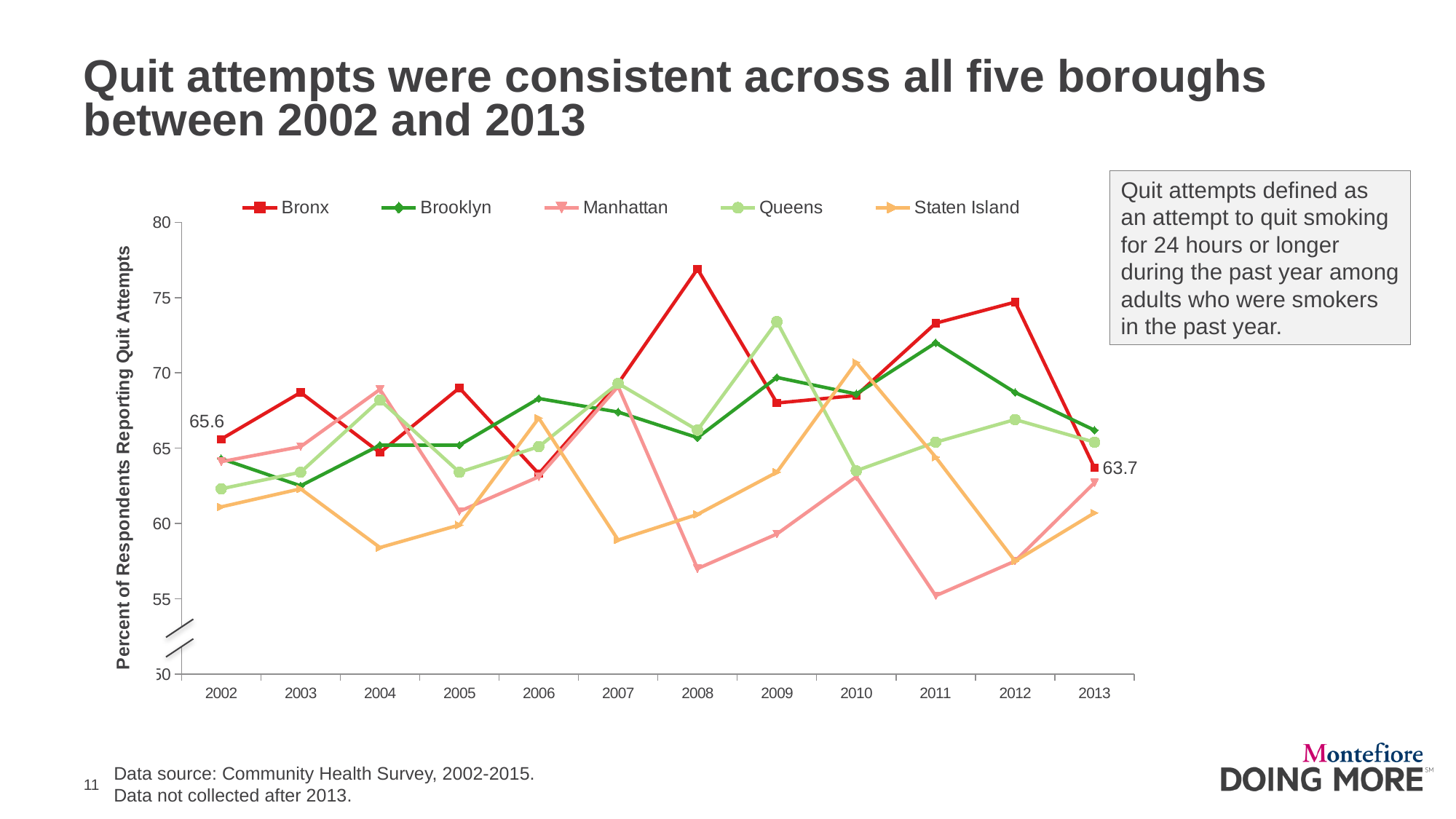
Which borough has the lowest value in 2011? Manhattan How many series does the legend list? 5 Which is larger for Bronx: the 2002 value or the 2013 value? 2002 How many years are shown on the x axis? 12 What is the difference between the Bronx value in 2002 and the Bronx value in 2013? 1.9 Which borough has the highest value in 2008? Bronx What is the value for Bronx in 2013? 63.7 What is the value for Bronx in 2002? 65.6 Is the value for Bronx in 2008 greater or less than 75? greater Is the value for Manhattan in 2011 greater or less than 60? less What is the title of the y axis? Percent of Respondents Reporting Quit Attempts What kind of chart is shown on the slide? Line chart